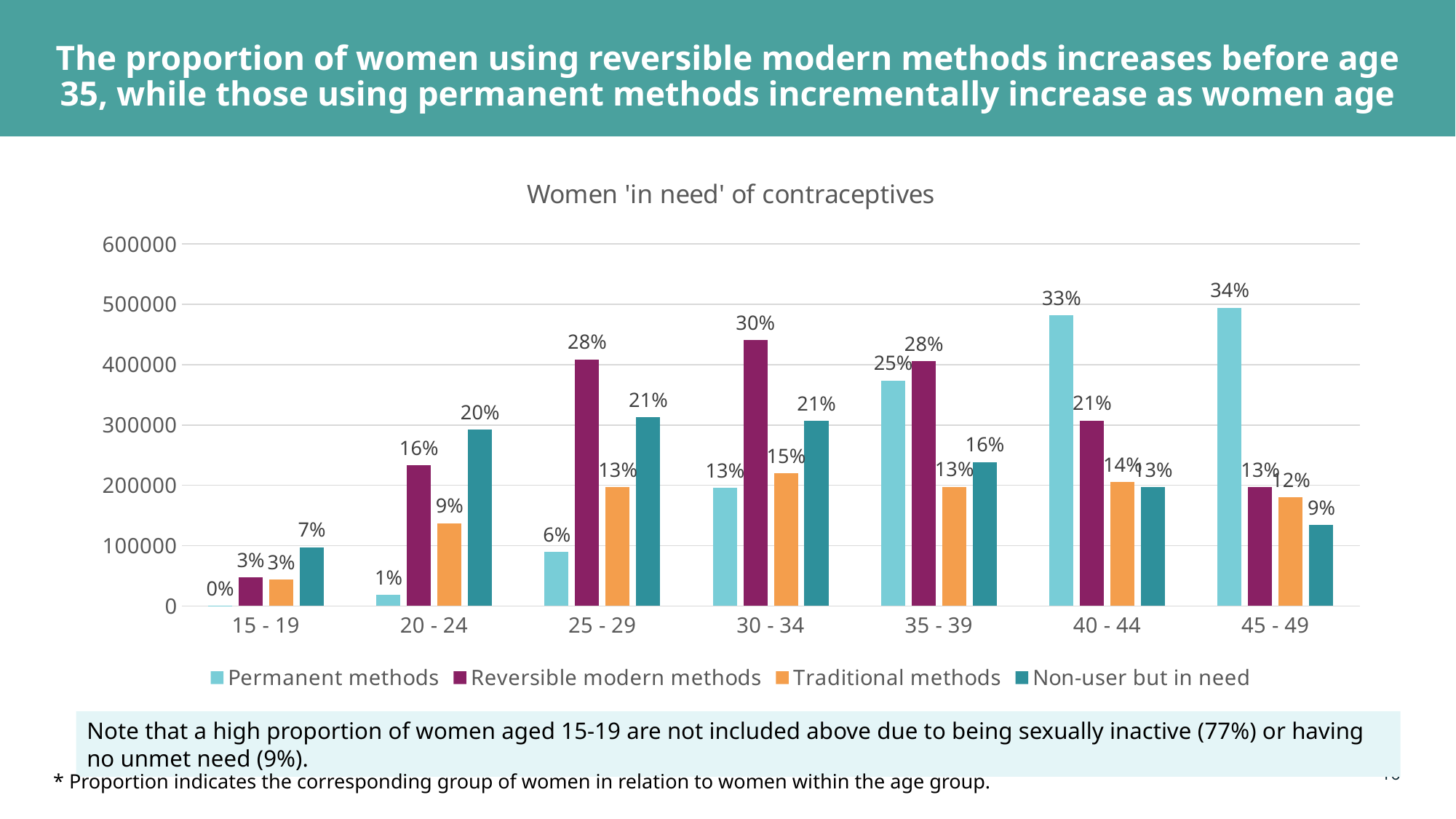
Is the Permanent methods bar for the 45 - 49 age group greater or less than 400000? greater What kind of chart is shown on the slide? bar chart In the 25 - 29 age group, which is larger: Reversible modern methods or Non-user but in need? Reversible modern methods What percentage label is shown for Non-user but in need in the 20 - 24 age group? 20% What percentage label is shown for Reversible modern methods in the 30 - 34 age group? 30% Do the Permanent methods values rise or fall as the age groups increase from 15 - 19 to 45 - 49? rise Which age group has the highest labelled percentage for Reversible modern methods? 30 - 34 How many series does the legend list? 4 What percentage label is shown for Permanent methods in the 45 - 49 age group? 34% Which age group has the lowest labelled percentage for Non-user but in need? 15 - 19 What is the difference in percentage points between the Permanent methods labels for the 40 - 44 and 35 - 39 age groups? 8 percentage points How many age groups are shown on the x axis? 7